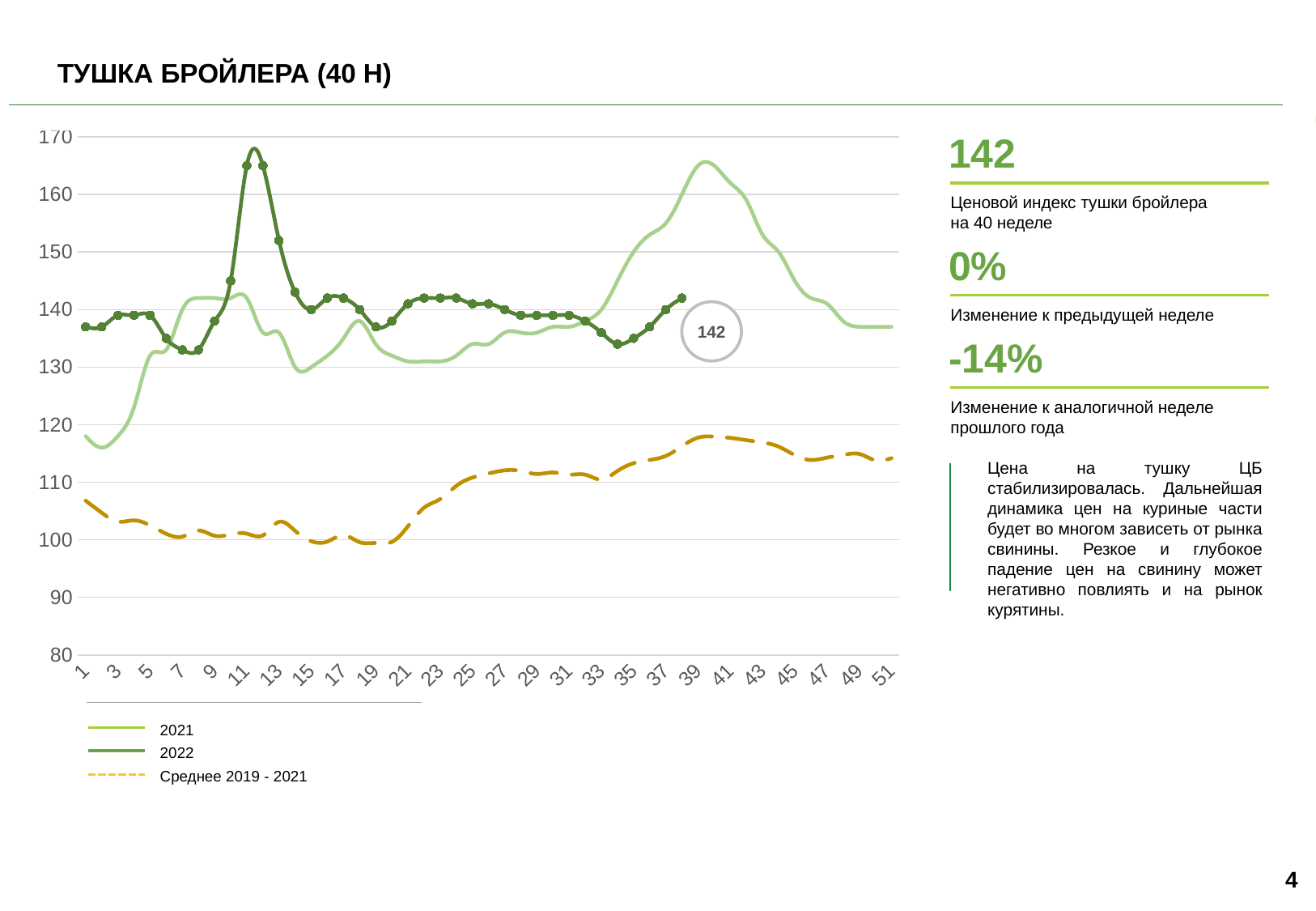
What value is printed in the data label at the end of the 2022 line? 142 Does the 2021 line rise or fall between week 40 and week 49? fall Is the value of the 2022 line at week 11 greater or less than 160? greater Which series has the lowest values across the whole chart? Среднее 2019 - 2021 At week 11, which line is higher: 2021 or 2022? 2022 At week 40, which line is higher: 2021 or Среднее 2019 - 2021? 2021 Is the value of the Среднее 2019 - 2021 line at week 1 greater or less than 100? greater Is the value of the 2021 line at week 40 greater or less than 160? greater Which legend series is drawn with a dashed line? Среднее 2019 - 2021 How many series does the chart legend list? 3 What kind of chart is shown on the slide? line chart